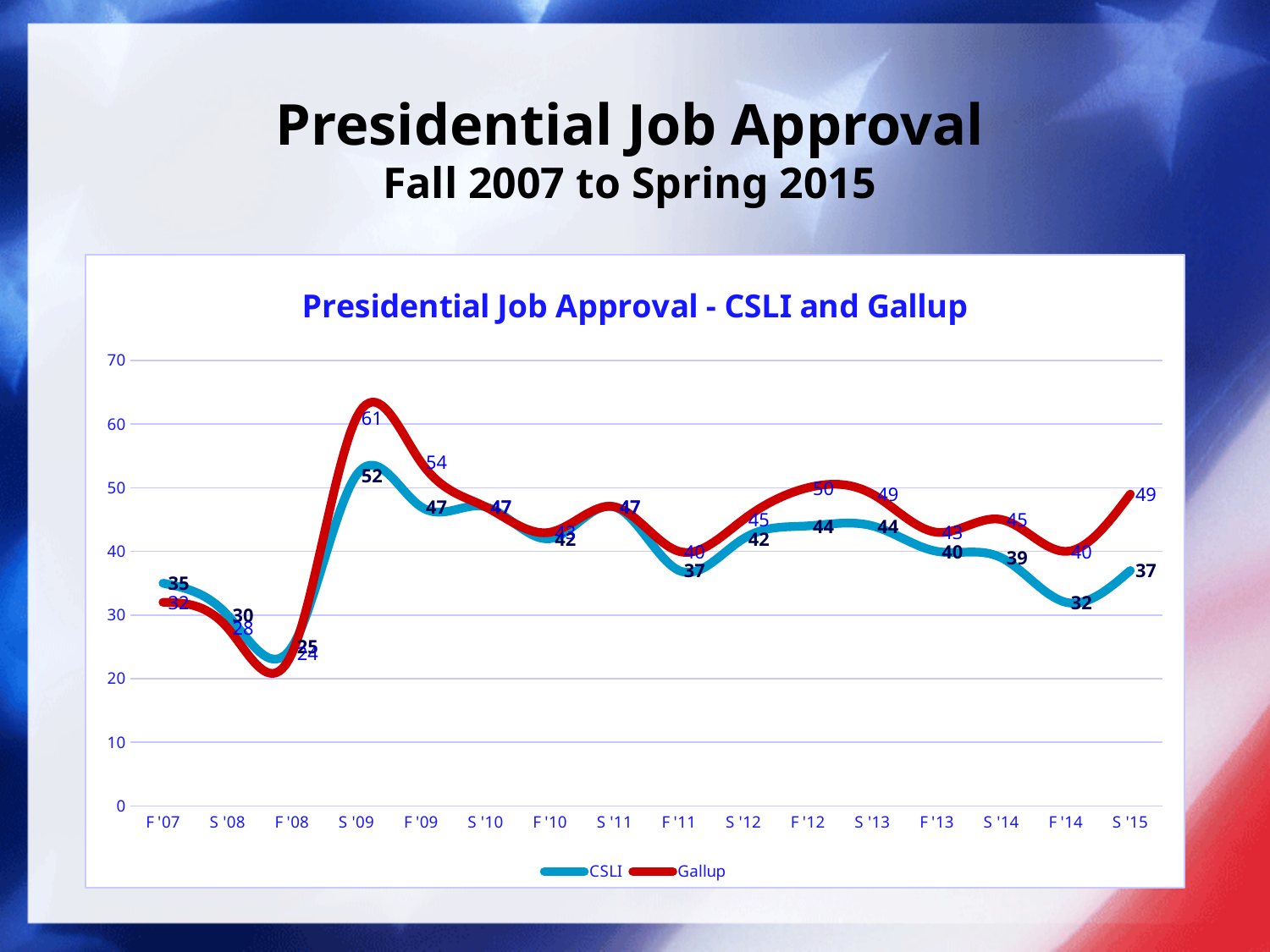
Which series has the higher value at F '09, CSLI or Gallup? Gallup At which time point does the Gallup series reach its highest value? S '09 What type of chart is shown on the slide? line chart What is the Gallup value for S '09? 61 Does the CSLI series rise or fall from F '13 to F '14? fall How many series does the legend list? 2 At which time point does the CSLI series reach its lowest value? F '08 How many time points are plotted along the x axis? 16 What is the title of the chart? Presidential Job Approval - CSLI and Gallup What is the CSLI value for S '15? 37 What is the difference between the Gallup and CSLI values at S '15? 12 What is the CSLI value for F '14? 32